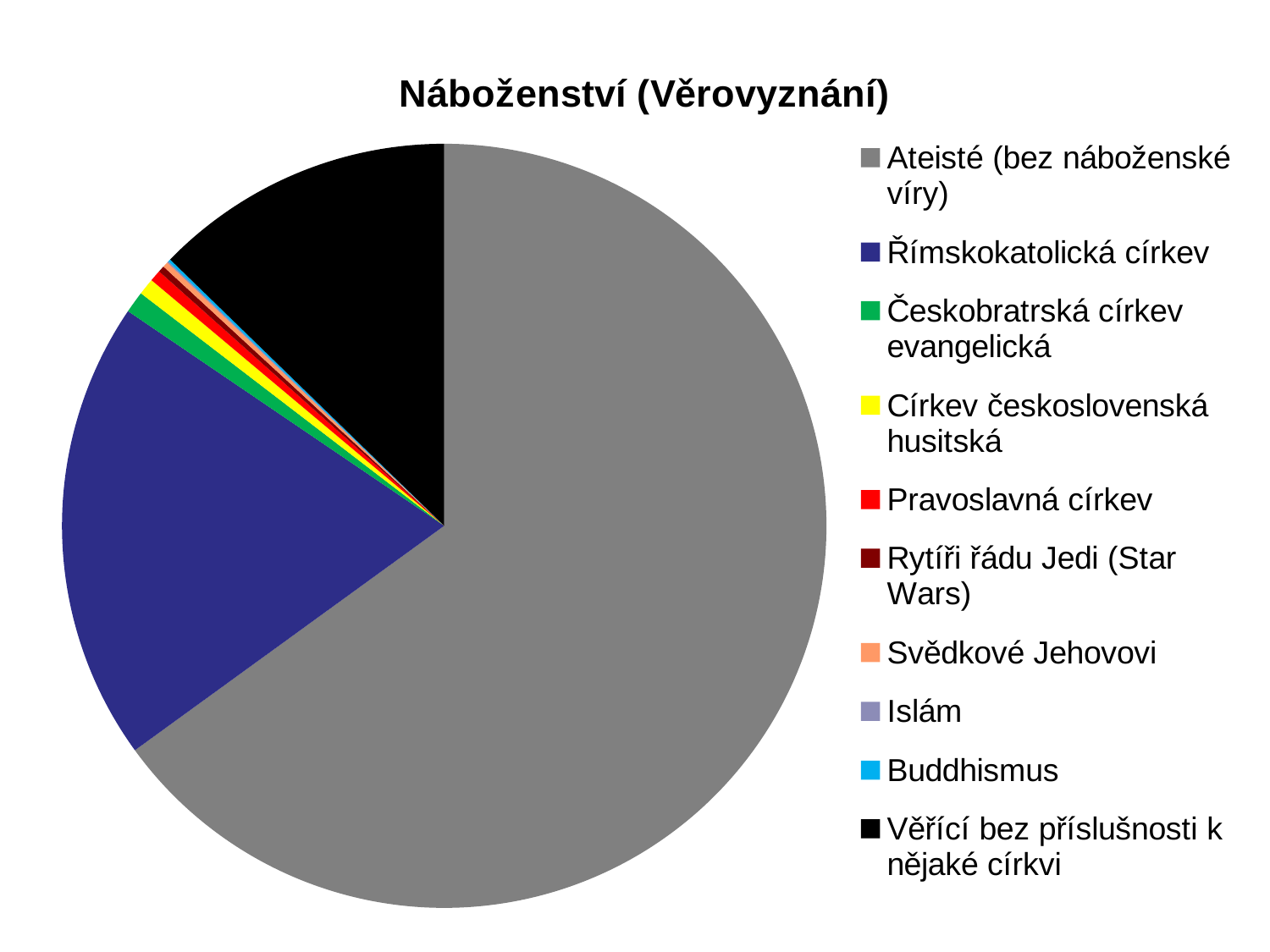
Which slice is larger: Ateisté (bez náboženské víry) or Římskokatolická církev? Ateisté (bez náboženské víry) Which slice is larger: Římskokatolická církev or Věřící bez příslušnosti k nějaké církvi? Římskokatolická církev Which category has the largest slice of the pie? Ateisté (bez náboženské víry) What colour is the slice for Věřící bez příslušnosti k nějaké církvi? black What kind of chart is shown on the slide? pie chart Which slice is larger: Českobratrská církev evangelická or Pravoslavná církev? Českobratrská církev evangelická How many categories does the pie chart's legend list? 10 Which category is the second largest slice of the pie? Římskokatolická církev What is the title of the chart? Náboženství (Věrovyznání)